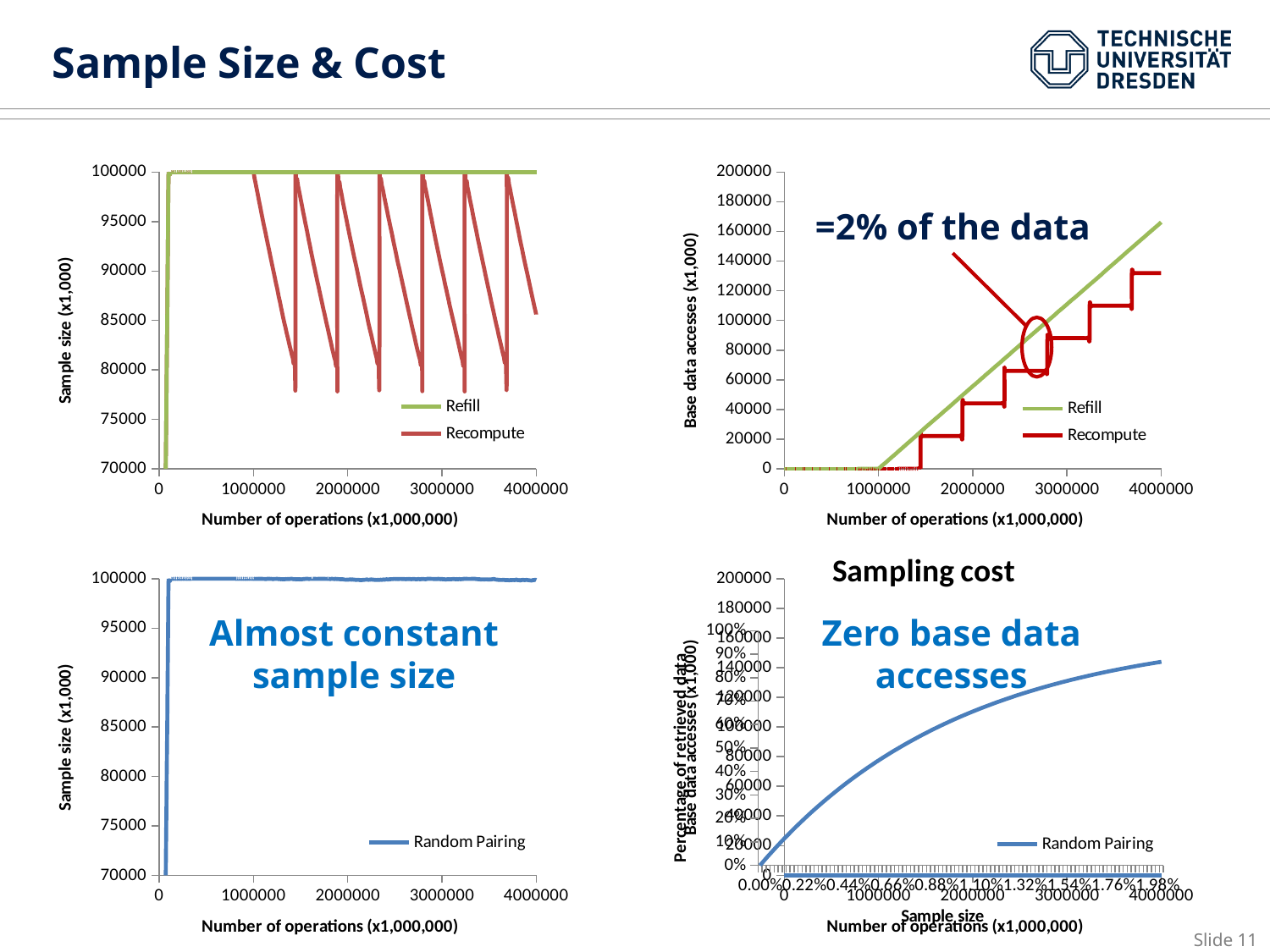
In the top-right chart, does the Refill series rise or fall as the number of operations increases beyond 1000000? rises In the bottom-left chart, how many series does the legend list? 1 In the bottom-left chart, is the sample size at 4000000 operations greater or less than 95000? greater In the bottom-right chart, does the Random Pairing series rise or fall as the number of operations increases? rises In the top-left chart, how many series does the legend list? 2 What is the title shown above the bottom-right chart? Sampling cost In the top-left chart, what are the two series named in the legend? Refill and Recompute In the top-right chart, which series has the higher value at 4000000 operations, Refill or Recompute? Refill In the top-left chart, is the lowest value reached by the Recompute series greater or less than 80000? less In the top-right chart, is the value of Refill at 4000000 operations greater or less than 140000? greater In the top-left chart, what kind of chart is shown? line chart